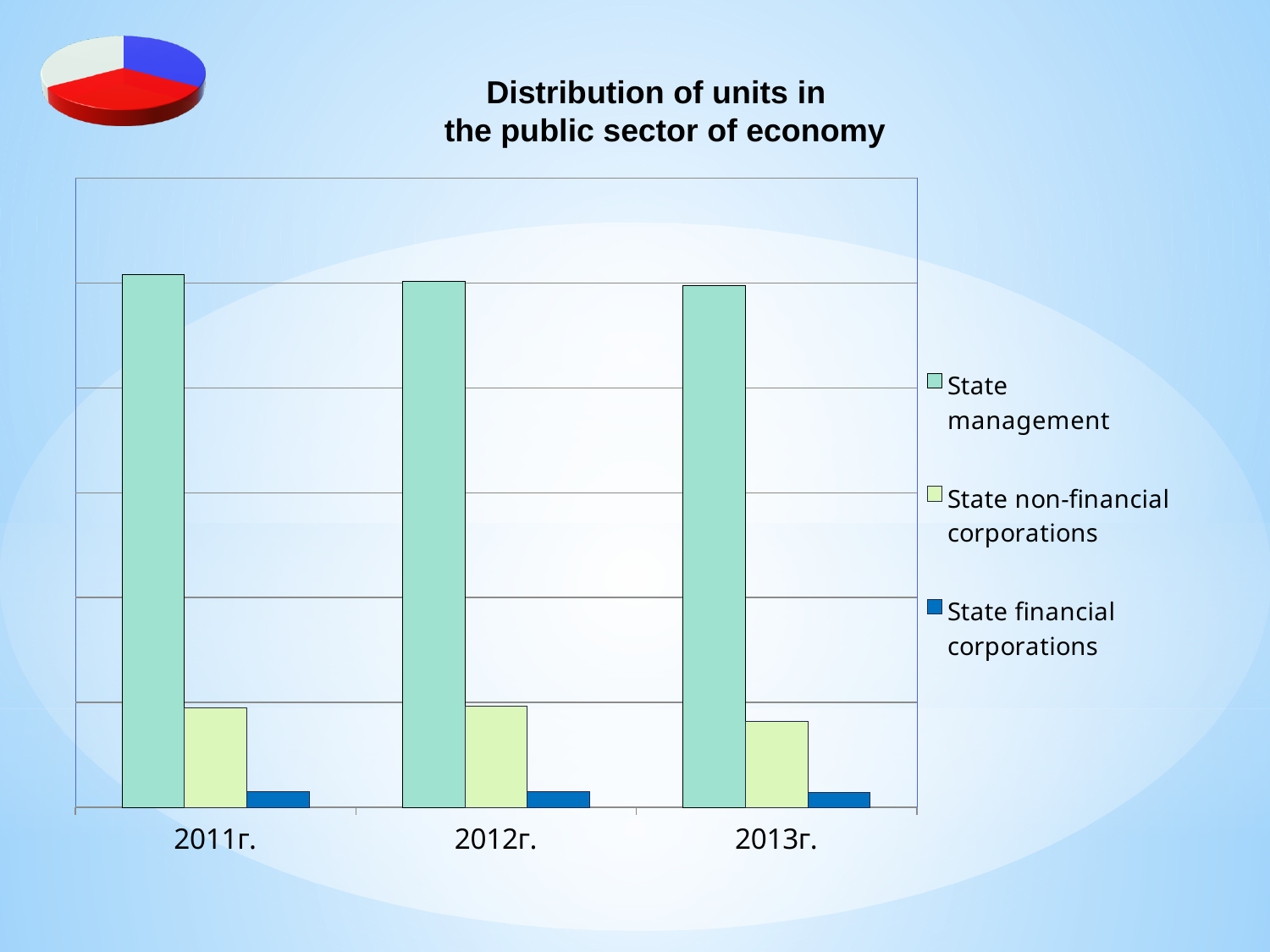
Which series has the highest value in 2011г.? State management How many series does the legend list? 3 Which is larger in 2013г.: State management or State non-financial corporations? State management What is the title of the chart? Distribution of units in the public sector of economy Which series is shown in dark blue in the legend? State financial corporations Which year has the lowest value for State non-financial corporations? 2013г. Do the values for State management rise or fall from 2011г. to 2013г.? fall How many years are shown on the x axis? 3 What kind of chart is shown on the slide? bar chart Which series has the lowest value in 2013г.? State financial corporations In 2012г., which is larger: State non-financial corporations or State financial corporations? State non-financial corporations Which year has the highest value for State management? 2011г.